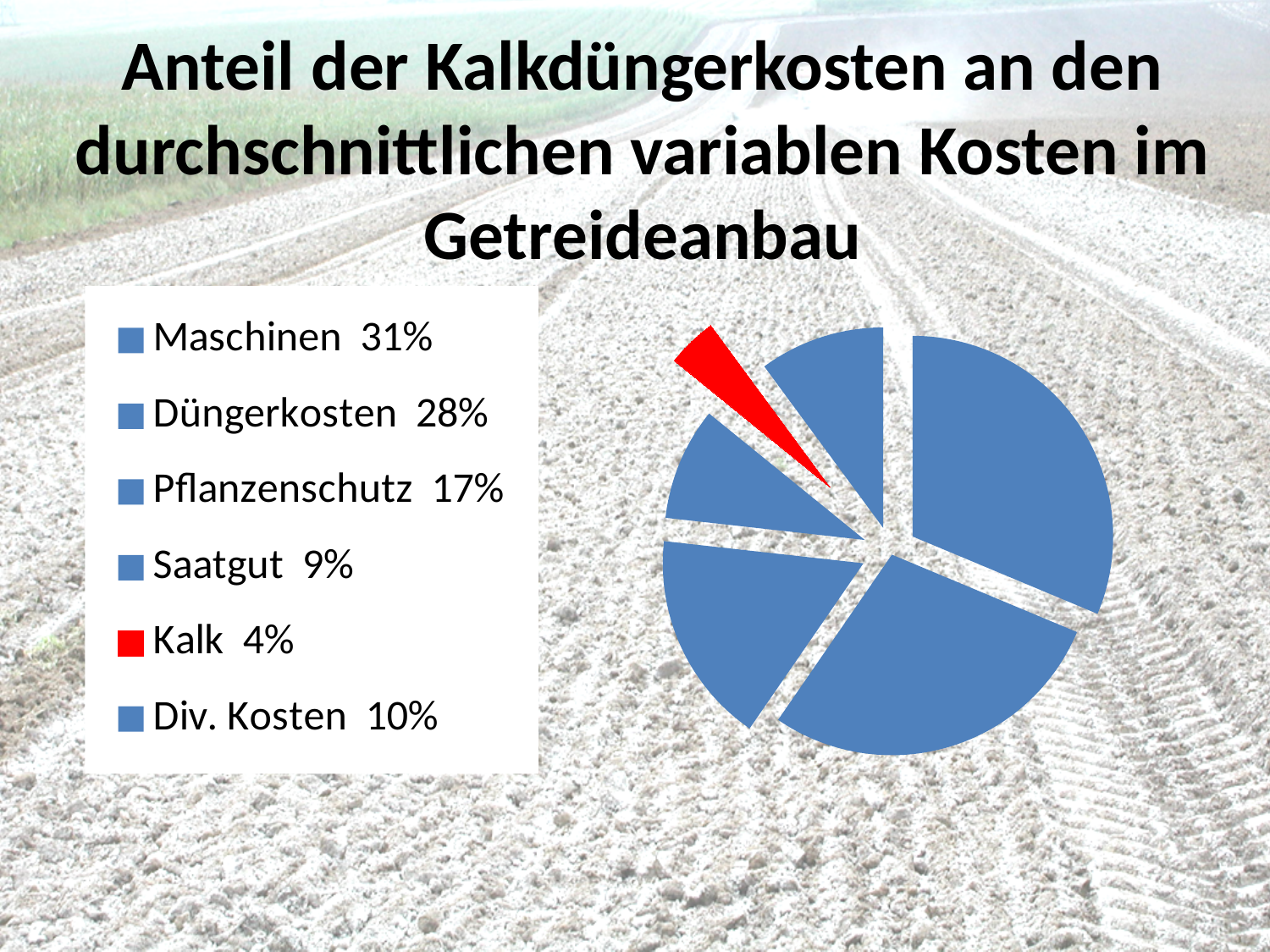
What share of the variable costs is Pflanzenschutz? 17% How many categories does the legend list? 6 What share of the variable costs is Div. Kosten? 10% Which is larger, the share for Saatgut or the share for Div. Kosten? Div. Kosten What share of the variable costs is Düngerkosten? 28% What share of the variable costs is Maschinen? 31% What is the difference in percentage points between Maschinen and Düngerkosten? 3 Which category has the largest share of the pie? Maschinen What share of the variable costs is Kalk? 4% What kind of chart is shown on the slide? pie chart Which category has the smallest share of the pie? Kalk Which category is shown in red in the pie chart? Kalk